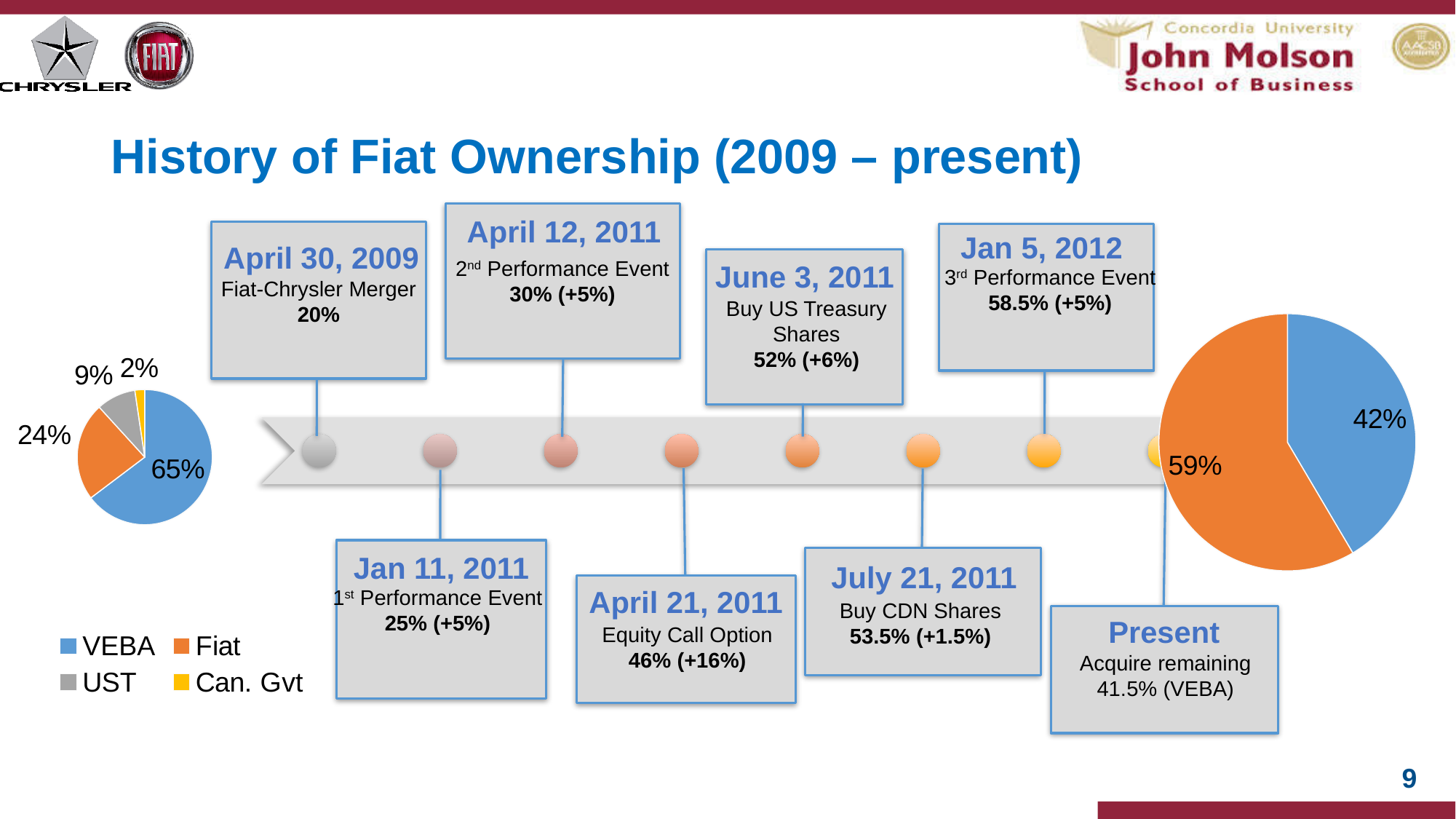
How many entries does the legend below the left pie chart list? 4 In the pie chart on the right of the slide, which is larger, the Fiat slice or the VEBA slice? Fiat In the pie chart on the right of the slide, what share does Fiat hold? 59% In the pie chart on the left of the slide, what share does UST hold? 9% In the pie chart on the left of the slide, what share does VEBA hold? 65% In the pie chart on the left of the slide, how many slices are there? 4 In the pie chart on the left of the slide, what is the difference between the VEBA share and the Fiat share? 41% In the pie chart on the left of the slide, which category has the largest slice? VEBA In the pie chart on the right of the slide, what share does VEBA hold? 42% In the pie chart on the left of the slide, which category has the smallest slice? Can. Gvt In the pie chart on the left of the slide, what share does Can. Gvt hold? 2% In the pie chart on the left of the slide, what share does Fiat hold? 24%